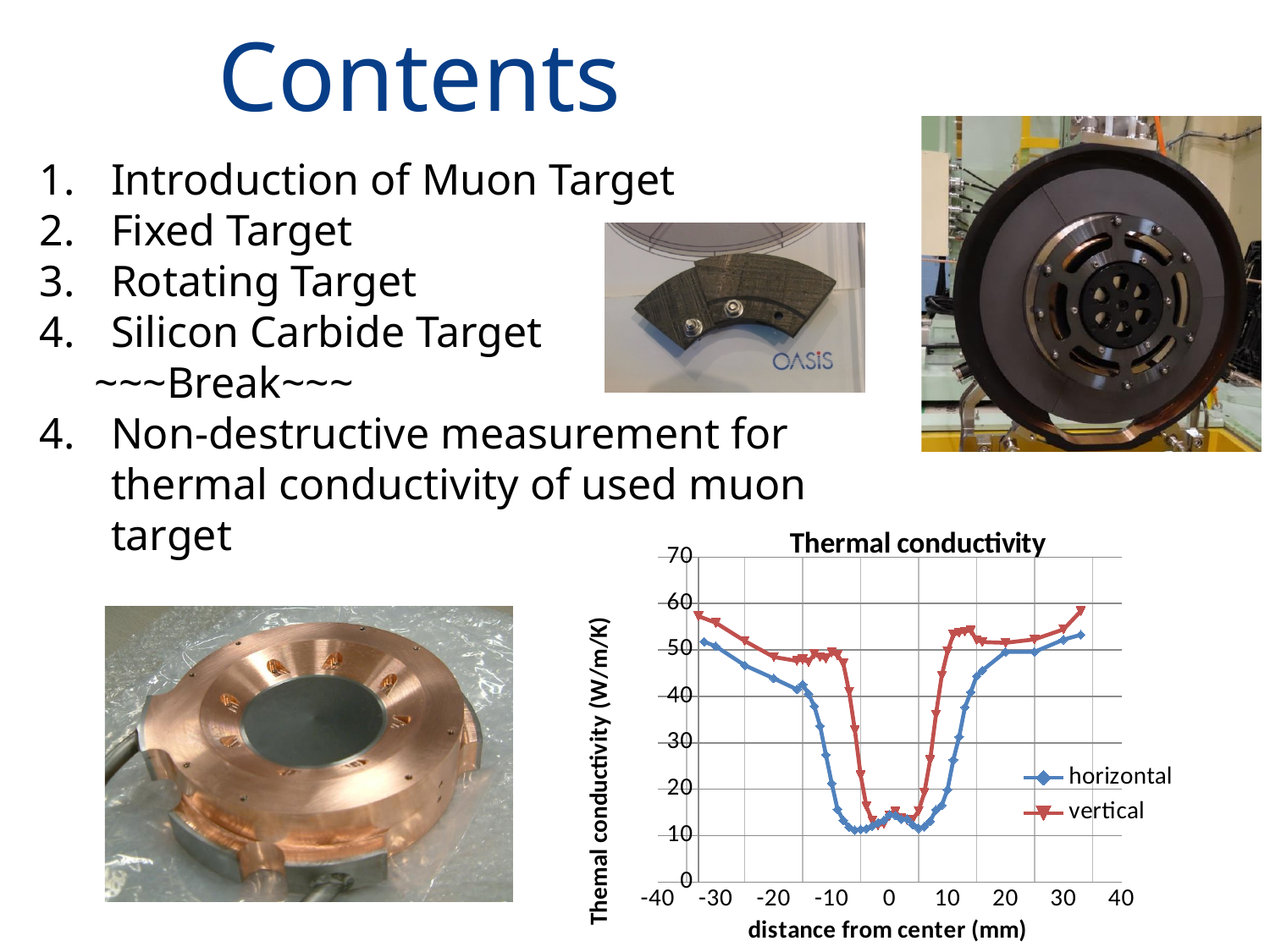
How many series does the legend of the "Thermal conductivity" chart list? 2 In the "Thermal conductivity" chart, is the horizontal series value at 15 mm greater or less than 50? less In the "Thermal conductivity" chart, is the horizontal series value at 0 mm greater or less than 20? less In the "Thermal conductivity" chart, which series has the higher value at 15 mm, horizontal or vertical? vertical What are the two series named in the legend of the "Thermal conductivity" chart? horizontal and vertical In the "Thermal conductivity" chart, is the vertical series value at -30 mm greater or less than 50? greater In the "Thermal conductivity" chart, does the horizontal series rise or fall as the distance goes from -30 mm to 0 mm? fall What kind of chart is the "Thermal conductivity" chart? line chart What is the x-axis label of the "Thermal conductivity" chart? distance from center (mm) In the "Thermal conductivity" chart, which series has the higher value at -30 mm, horizontal or vertical? vertical